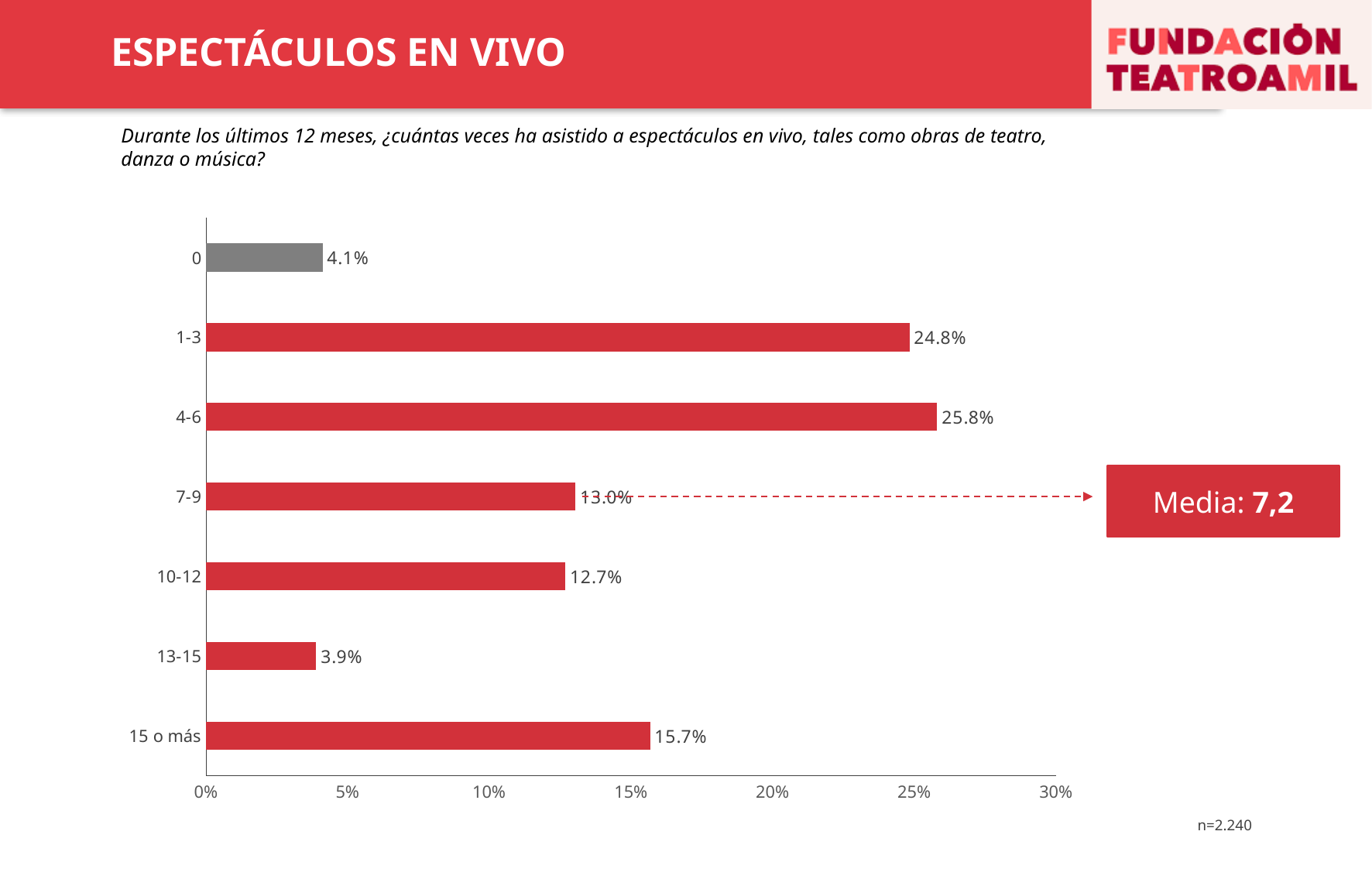
What is the value shown for the '0' category? 4.1% What is the value shown for the '15 o más' category? 15.7% What is the difference between the '4-6' and '1-3' values? 1.0% What percentage of respondents attended live shows 1-3 times in the last 12 months? 24.8% Is the value for '15 o más' greater or less than 15%? greater Which category has the lowest percentage? 13-15 Which is larger, the value for '7-9' or the value for '10-12'? 7-9 What is the sample size (n) shown on the slide? n=2.240 What is the mean (Media) value shown in the box next to the chart? 7,2 How many categories are shown on the chart? 7 Which category has the highest percentage? 4-6 What kind of chart is shown on the slide? Bar chart